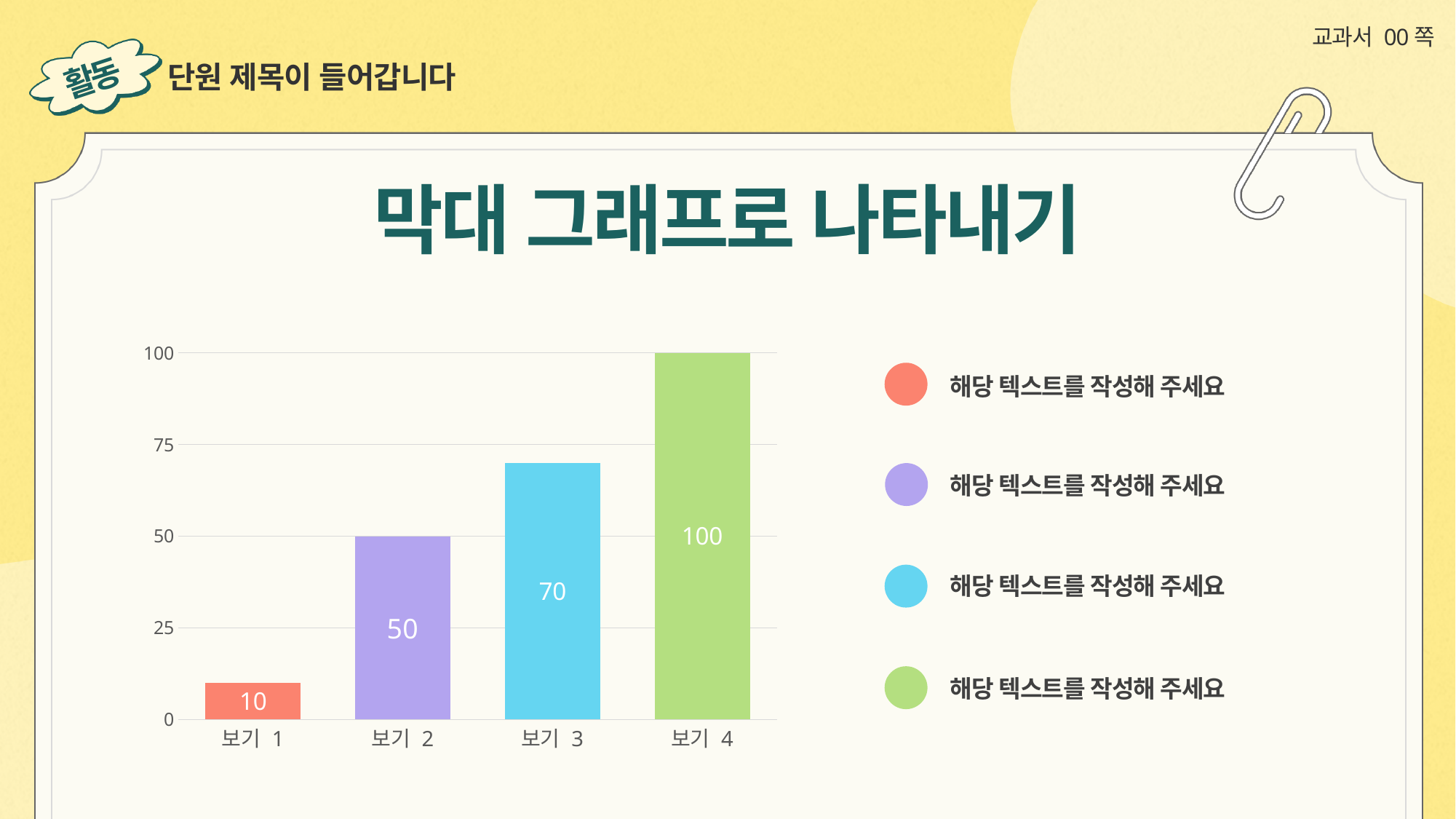
Which category has the lowest value? 보기 1 What is the difference between the values for 보기 3 and 보기 1? 60 Which is larger, the value for 보기 2 or the value for 보기 3? 보기 3 What is the value for 보기 1? 10 What is the title shown above the chart? 막대 그래프로 나타내기 What kind of chart is shown on the slide? bar chart What is the value for 보기 3? 70 Is the value for 보기 3 greater or less than 75? less What is the difference between the values for 보기 4 and 보기 2? 50 Which category has the highest value? 보기 4 Do the values rise or fall from 보기 1 to 보기 4? rise How many categories are shown on the x axis? 4